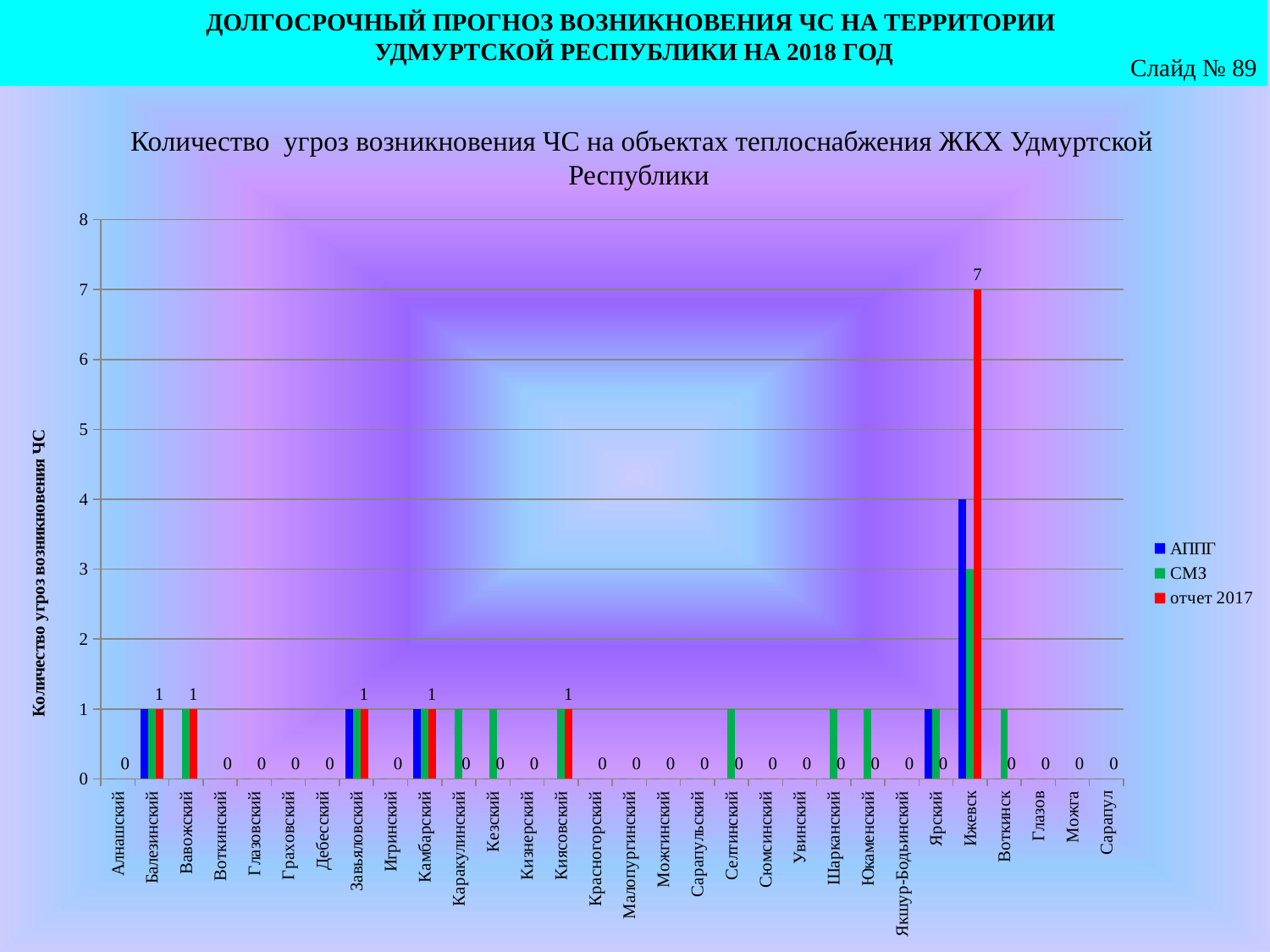
How many categories are shown on the x axis? 30 What is the value of the 'отчет 2017' series for Алнашский? 0 Which category has the highest value in the 'отчет 2017' series? Ижевск What is the value of the 'отчет 2017' series for Ижевск? 7 Which has a larger 'отчет 2017' value, Ижевск or Камбарский? Ижевск What kind of chart is shown on the slide? bar chart What is the value of the 'отчет 2017' series for Балезинский? 1 What are the three series listed in the legend? АППГ, СМЗ, отчет 2017 How many series does the legend list? 3 What is the value of the 'отчет 2017' series for Киясовский? 1 Is the 'АППГ' value for Ижевск greater or less than 2? greater What is the difference between the 'отчет 2017' values for Ижевск and Завьяловский? 6